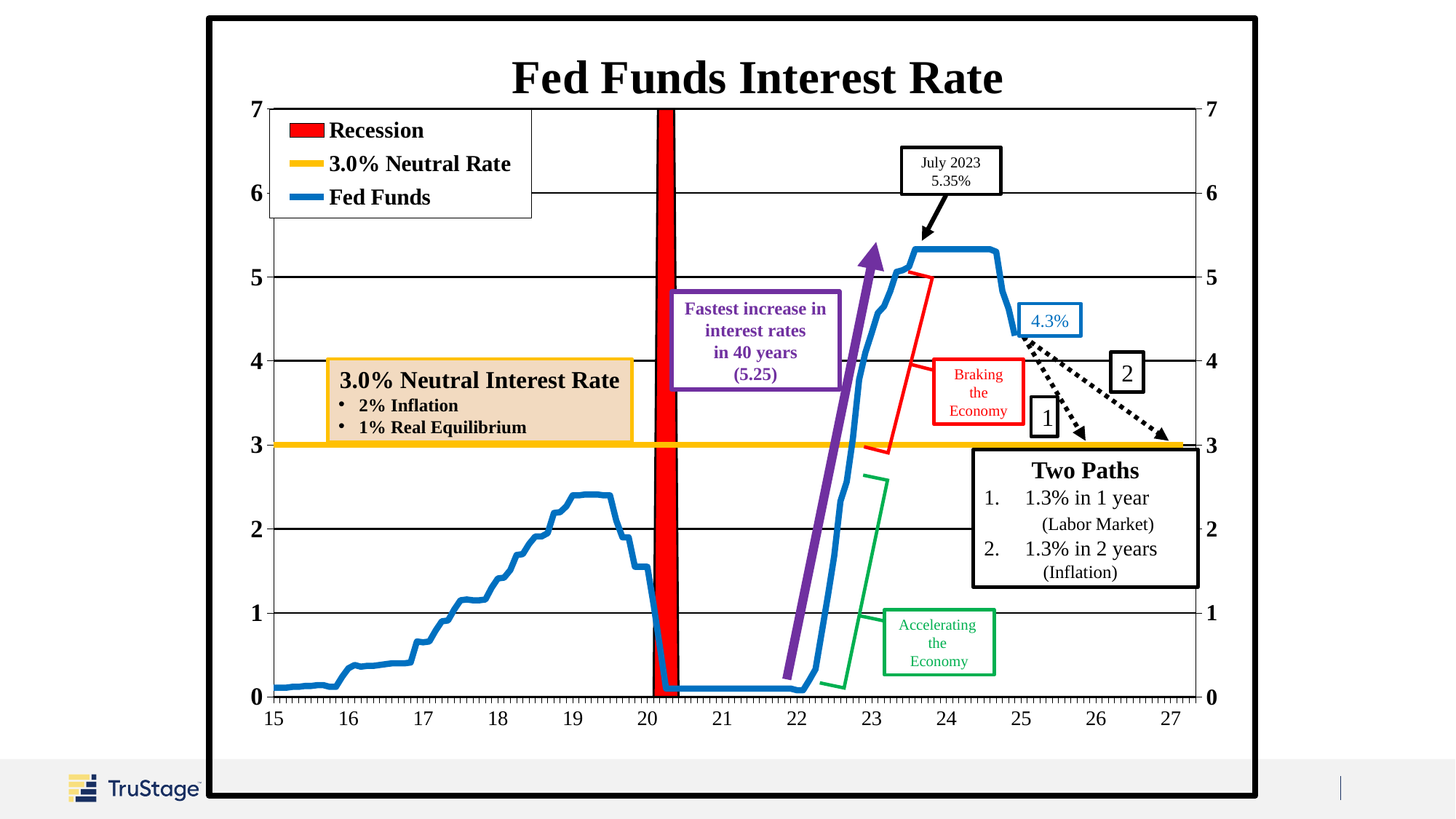
What value is labeled on the Fed Funds line near 2025? 4.3% Does the Fed Funds rate rise or fall between 2022 and 2023? rise Is the Fed Funds rate at the start of 2024 greater or less than 5? greater What is the value of the neutral interest rate line? 3.0% What is the difference between the 4.3% labeled rate and the 3.0% neutral rate? 1.3% How many entries does the chart legend list? 3 What Fed Funds rate is labeled for July 2023? 5.35% What kind of chart is used to show the Fed Funds rate? line chart What is the title of the chart? Fed Funds Interest Rate What colour is used for the Recession band in the legend? red Which is higher, the Fed Funds rate in 2019 or in 2024? 2024 Is the Fed Funds rate in 2021 greater or less than 1? less